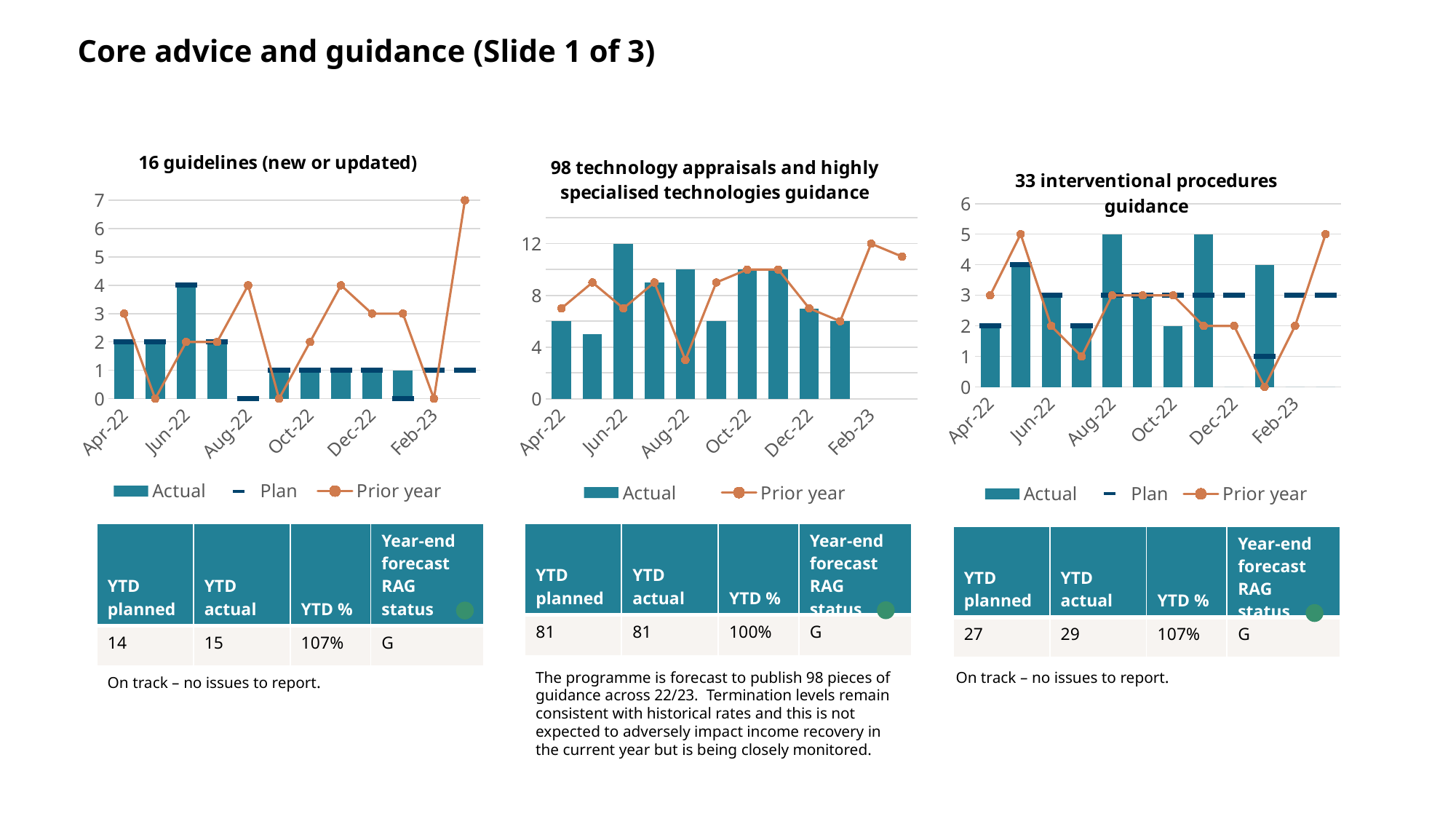
What kind of chart is the '16 guidelines (new or updated)' chart? A bar chart with a line In the '16 guidelines (new or updated)' chart, what is the Prior year value for Feb-23? 0 In the '98 technology appraisals and highly specialised technologies guidance' chart, is the Prior year value for Aug-22 greater or less than 4? less In the '16 guidelines (new or updated)' chart, which month has the highest Prior year value? Mar-23 In the '98 technology appraisals and highly specialised technologies guidance' chart, which month has the highest Actual bar? Jun-22 In the '98 technology appraisals and highly specialised technologies guidance' chart, is the Actual value for Jun-22 larger than the Actual value for Apr-22? Yes, Jun-22 In the '33 interventional procedures guidance' chart, is the Actual value for Aug-22 greater or less than 4? greater How many charts are shown on the slide? 3 In the '98 technology appraisals and highly specialised technologies guidance' chart, what is the Actual value for Jun-22? 12 In the '16 guidelines (new or updated)' chart, what is the Actual value for Jun-22? 4 How many series does the legend list for the '33 interventional procedures guidance' chart? 3 How many series does the legend list for the '98 technology appraisals and highly specialised technologies guidance' chart? 2